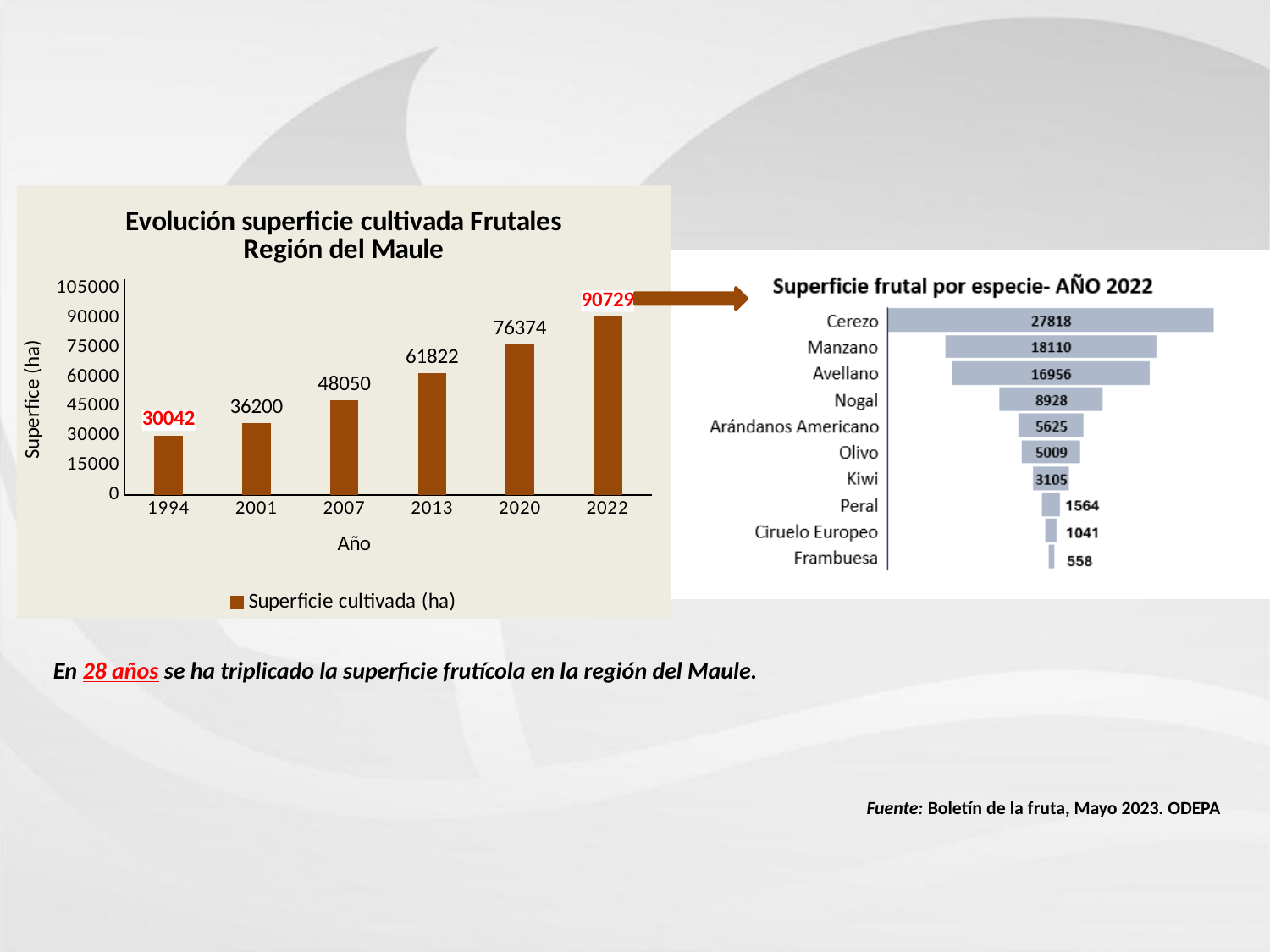
In the chart 'Evolución superficie cultivada Frutales Región del Maule', what is the value for 1994? 30042 In the chart 'Superficie frutal por especie- AÑO 2022', what is the value for Avellano? 16956 In the chart 'Evolución superficie cultivada Frutales Región del Maule', do the values rise or fall from 1994 to 2022? rise In the chart 'Superficie frutal por especie- AÑO 2022', which species has the lowest value? Frambuesa In the chart 'Evolución superficie cultivada Frutales Región del Maule', what is the value for 2013? 61822 In the chart 'Evolución superficie cultivada Frutales Región del Maule', what is the label of the y axis? Superfice (ha) In the chart 'Evolución superficie cultivada Frutales Región del Maule', how many years are shown on the x axis? 6 In the chart 'Evolución superficie cultivada Frutales Región del Maule', what is the difference between the values for 2022 and 1994? 60687 In the chart 'Superficie frutal por especie- AÑO 2022', what is the difference between Cerezo and Manzano? 9708 In the chart 'Evolución superficie cultivada Frutales Región del Maule', which year has the highest value? 2022 In the chart 'Superficie frutal por especie- AÑO 2022', which is larger, Nogal or Olivo? Nogal In the chart 'Superficie frutal por especie- AÑO 2022', how many species are listed? 10